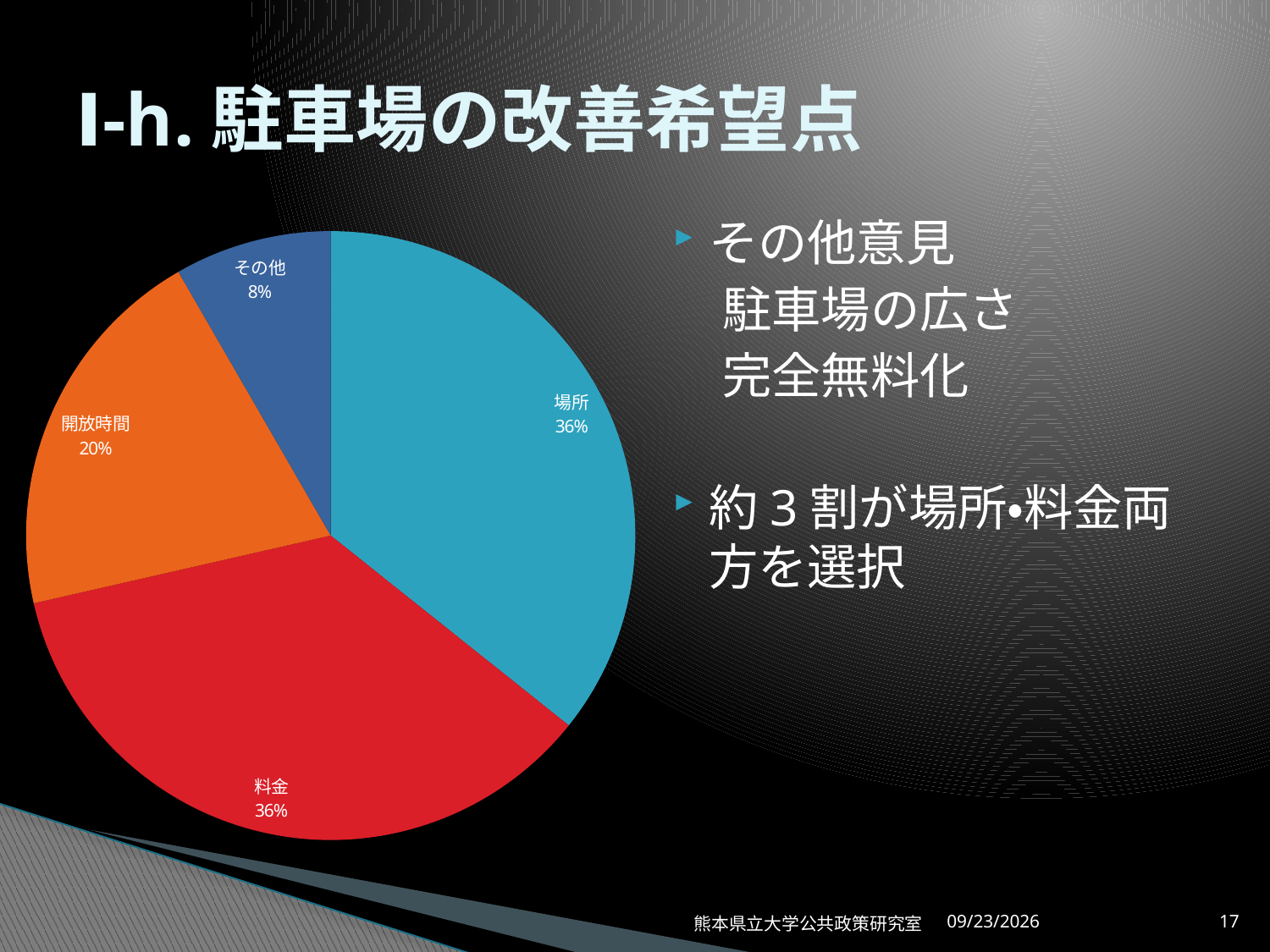
What kind of chart is shown on the slide? pie chart Which slice of the pie chart is the smallest? その他 How many slices does the pie chart have? 4 Which is larger in the pie chart, 開放時間 or その他? 開放時間 What percentage is shown for 開放時間 in the pie chart? 20% What percentage is shown for その他 in the pie chart? 8% What percentage is shown for 場所 in the pie chart? 36% What is the difference in percentage points between 開放時間 and その他 in the pie chart? 12% What colour is the 料金 slice in the pie chart? red What is the difference in percentage points between 料金 and 開放時間 in the pie chart? 16% What percentage is shown for 料金 in the pie chart? 36% Which is larger in the pie chart, 場所 or 開放時間? 場所